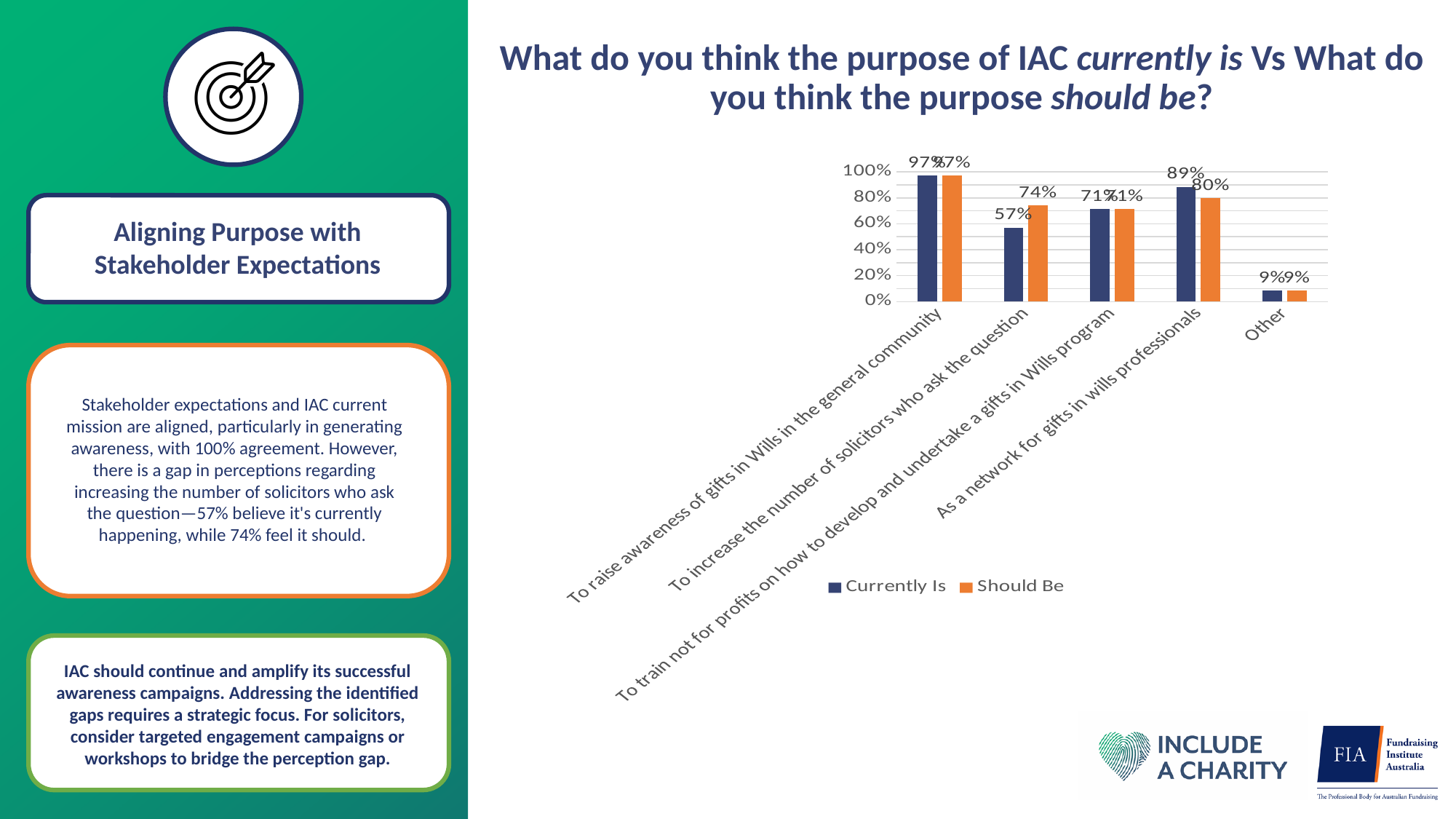
What is the 'Should Be' value for 'As a network for gifts in wills professionals'? 80% For 'As a network for gifts in wills professionals', which is larger: the 'Currently Is' value or the 'Should Be' value? Currently Is How many categories are shown on the x axis of the chart? 5 What is the 'Currently Is' value for 'To increase the number of solicitors who ask the question'? 57% Which category has the lowest 'Should Be' value? Other What is the 'Currently Is' value for 'As a network for gifts in wills professionals'? 89% What type of chart is shown on the slide? Bar chart Which category has the highest 'Currently Is' value? To raise awareness of gifts in Wills in the general community What is the 'Should Be' value for 'To increase the number of solicitors who ask the question'? 74% What is the difference between the 'Should Be' and 'Currently Is' values for 'To increase the number of solicitors who ask the question'? 17% What is the 'Currently Is' value for 'Other'? 9% How many series does the chart legend list? 2